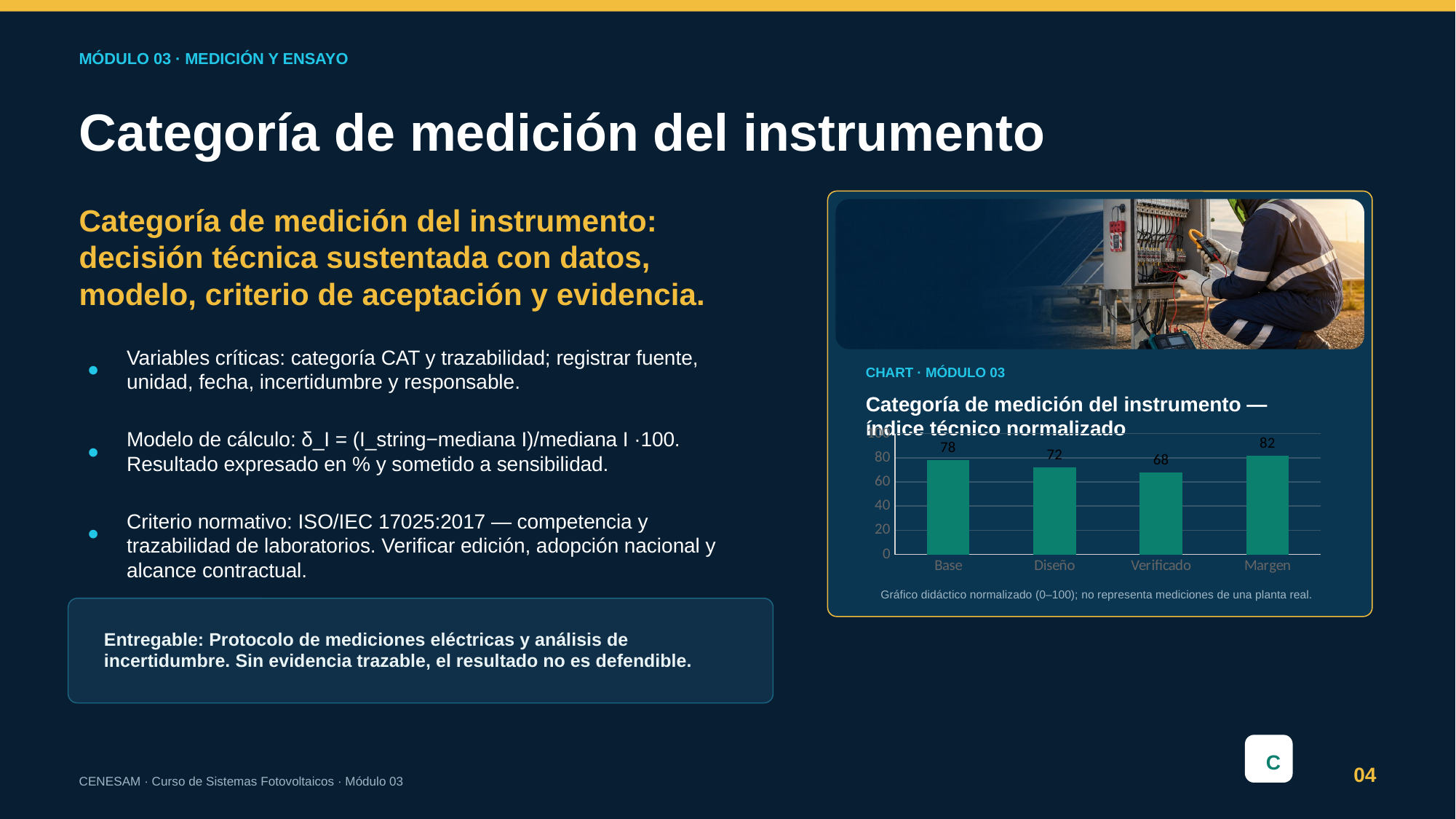
Which category has the lowest value? Verificado What is the value for Verificado? 68 What is the value for Margen? 82 Is the value for Verificado greater or less than 80? less What kind of chart is shown on the slide? bar chart Which is larger, the value for Base or the value for Diseño? Base What is the title of the chart? Categoría de medición del instrumento — índice técnico normalizado What is the value for Base? 78 Which category has the highest value? Margen What is the difference between the values for Margen and Verificado? 14 What is the value for Diseño? 72 How many categories are shown on the x axis? 4